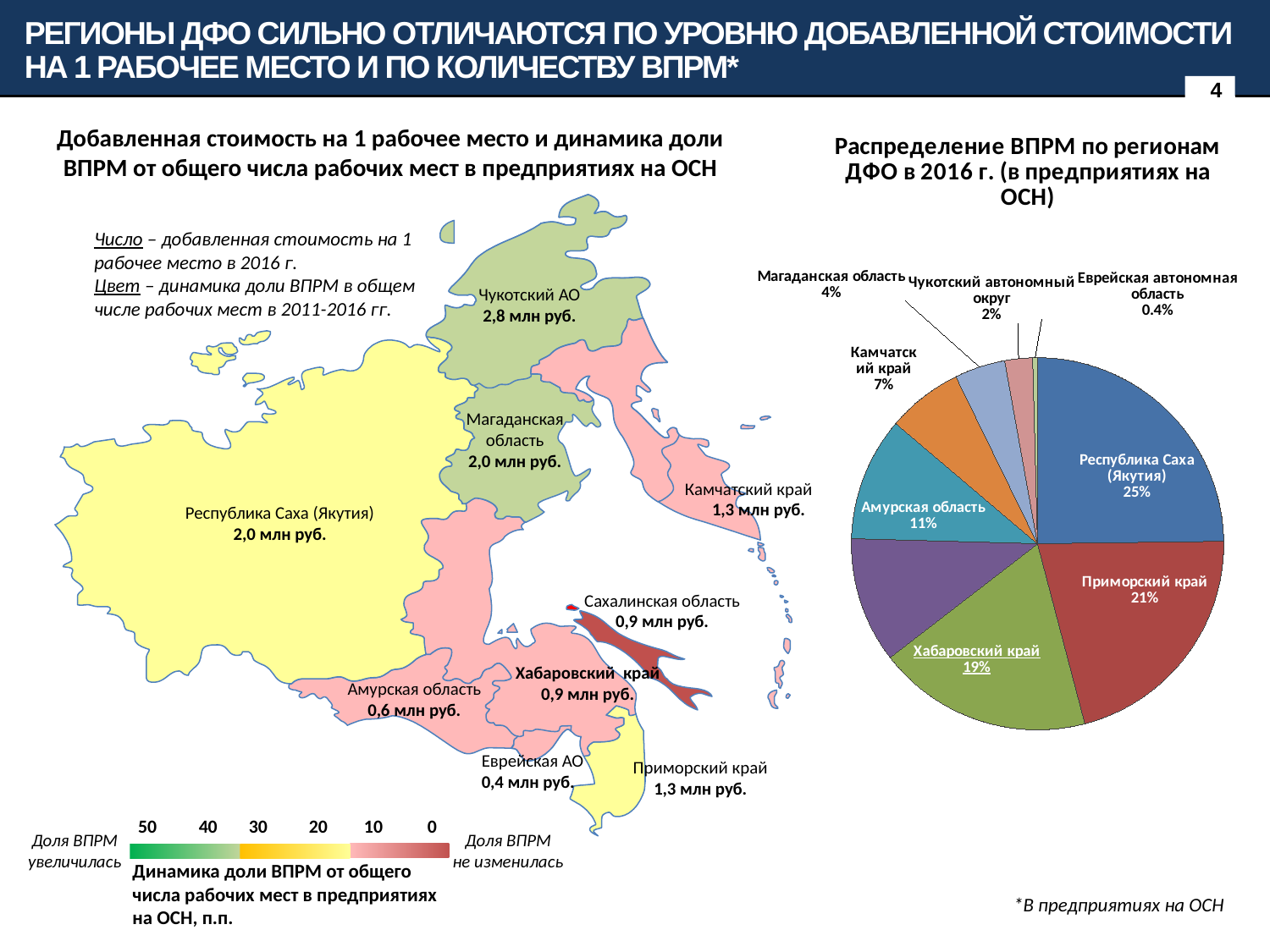
In the pie chart «Распределение ВПРМ по регионам ДФО в 2016 г.», what share does Республика Саха (Якутия) have? 25% In the pie chart «Распределение ВПРМ по регионам ДФО в 2016 г.», which labelled region has the largest share? Республика Саха (Якутия) On the map «Добавленная стоимость на 1 рабочее место...», what is the value added per workplace shown for Чукотский АО? 2,8 млн руб. In the pie chart «Распределение ВПРМ по регионам ДФО в 2016 г.», what share does Хабаровский край have? 19% On the map «Добавленная стоимость на 1 рабочее место...», what is the value added per workplace shown for Амурская область? 0,6 млн руб. In the pie chart «Распределение ВПРМ по регионам ДФО в 2016 г.», what share does Еврейская автономная область have? 0.4% In the pie chart «Распределение ВПРМ по регионам ДФО в 2016 г.», which has the larger share: Амурская область or Камчатский край? Амурская область In the pie chart «Распределение ВПРМ по регионам ДФО в 2016 г.», by how many percentage points does the share of Приморский край exceed that of Хабаровский край? 2 percentage points What kind of chart is the chart titled «Распределение ВПРМ по регионам ДФО в 2016 г. (в предприятиях на ОСН)»? Pie chart In the pie chart «Распределение ВПРМ по регионам ДФО в 2016 г.», which labelled region has the smallest share? Еврейская автономная область On the map «Добавленная стоимость на 1 рабочее место...», which region has the highest value added per workplace? Чукотский АО